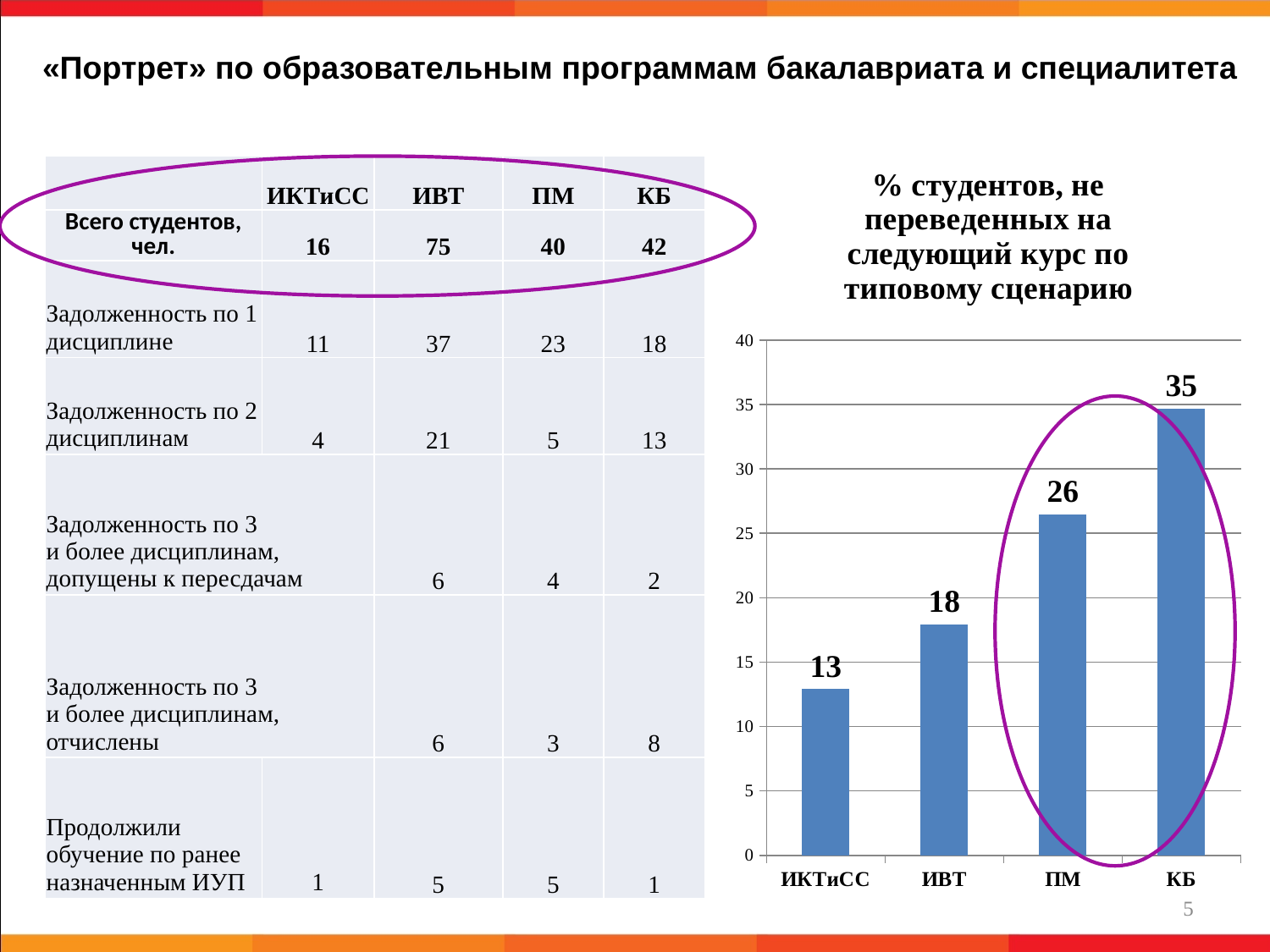
What is the value for ИВТ in the chart? 18 What is the difference between the values for КБ and ИКТиСС? 22 What is the value for ИКТиСС in the chart? 13 Which category has the lowest value in the chart? ИКТиСС What is the value for КБ in the chart? 35 What is the value for ПМ in the chart? 26 What kind of chart is shown on the slide? bar chart Is the value for ПМ greater or less than 20? greater What is the difference between the values for ПМ and ИВТ? 8 How many categories are shown in the chart? 4 Which category has the highest value in the chart? КБ Which is larger, the value for ПМ or the value for ИВТ? ПМ